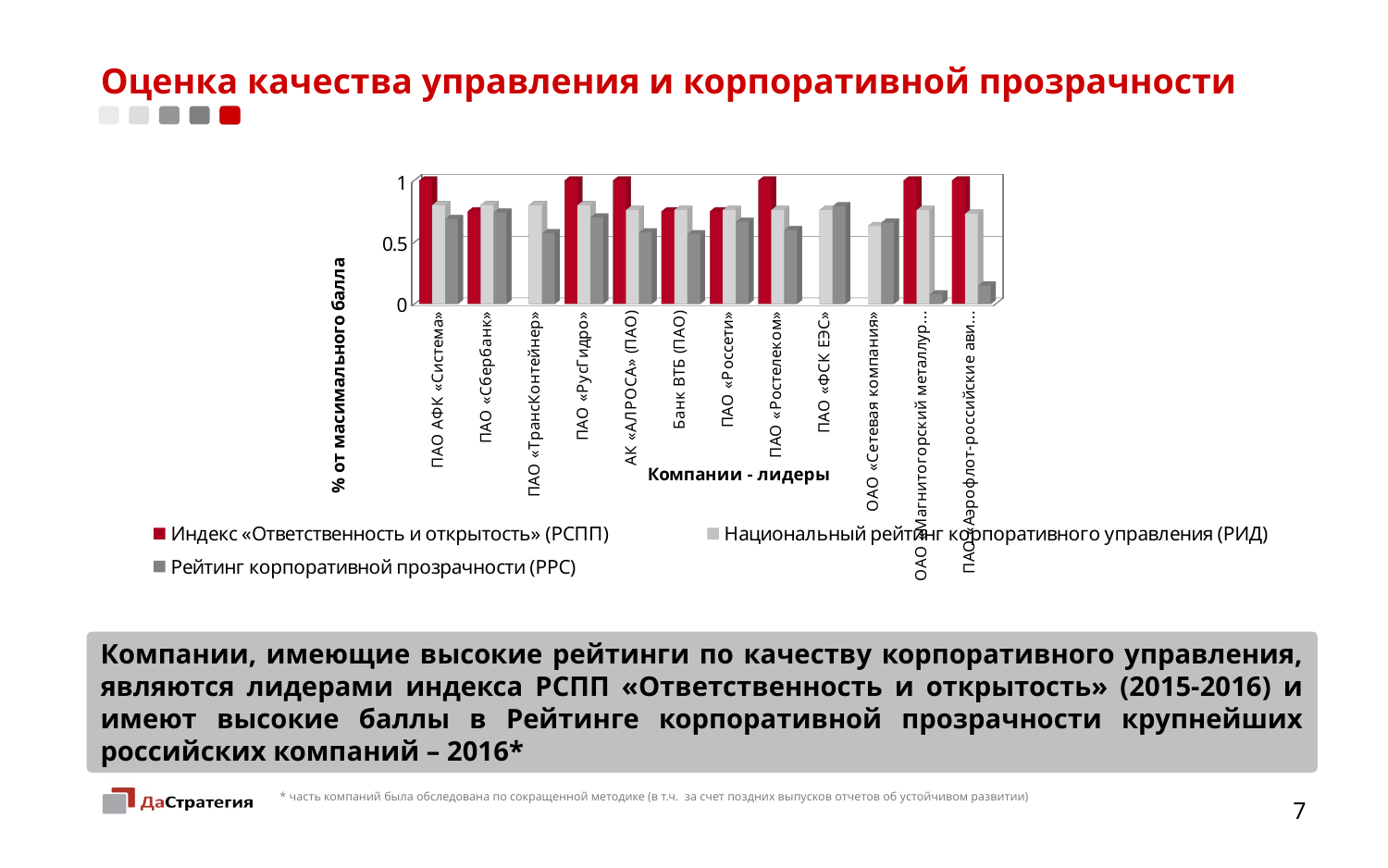
How many companies are shown on the x axis of the chart? 12 For ОАО «Магнитогорский металлур...», which is larger: Индекс «Ответственность и открытость» (РСПП) or Рейтинг корпоративной прозрачности (РРС)? Индекс «Ответственность и открытость» (РСПП) Which series in the chart is shown in red? Индекс «Ответственность и открытость» (РСПП) Is the value of Национальный рейтинг корпоративного управления (РИД) for ПАО «ТрансКонтейнер» greater or less than 0.5? greater Is the value of Индекс «Ответственность и открытость» (РСПП) for ПАО «Сбербанк» greater or less than 0.5? greater What kind of chart is shown on the slide? bar chart How many series does the chart legend list? 3 Is the value of Рейтинг корпоративной прозрачности (РРС) for ПАО «Аэрофлот-российские ави...» greater or less than 0.5? less For ПАО «Аэрофлот-российские ави...», which is larger: Национальный рейтинг корпоративного управления (РИД) or Рейтинг корпоративной прозрачности (РРС)? Национальный рейтинг корпоративного управления (РИД) What is the title of the vertical axis of the chart? % от масимального балла What is the title of the horizontal axis of the chart? Компании - лидеры